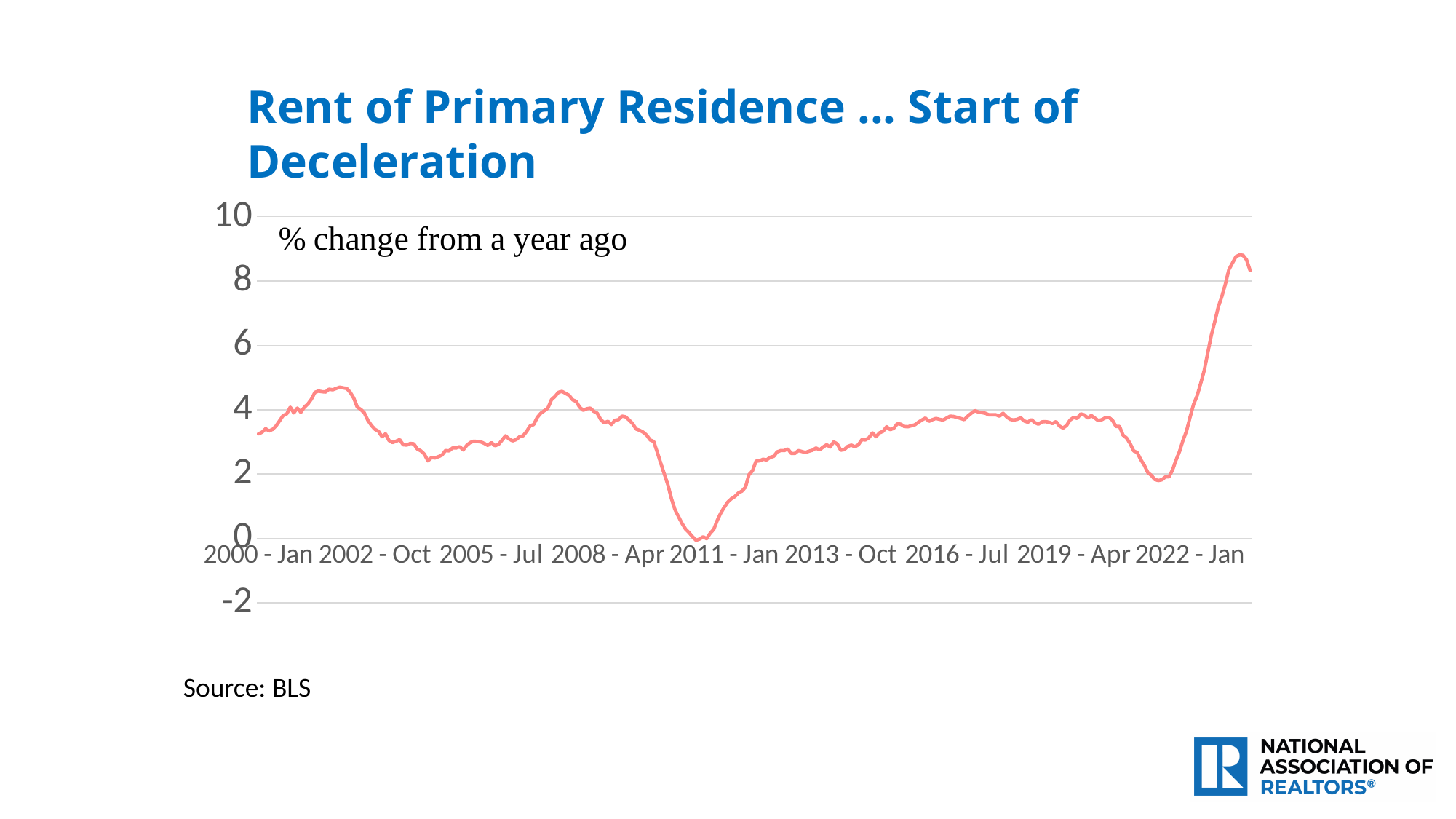
What kind of chart is shown on the slide? line chart Is the value at 2000 - Jan greater or less than 2? greater What does the text inside the plot area say the values represent? % change from a year ago Is the value at 2011 - Jan greater or less than 2? less How many date labels are shown on the x axis? 9 Is the value at 2019 - Apr greater or less than 6? less What is the title of the chart? Rent of Primary Residence … Start of Deceleration Does the line rise or fall between 2011 - Jan and 2013 - Oct? rise Which x-axis label is closest to the lowest point of the line? 2011 - Jan Does the line rise or fall between 2008 - Apr and 2011 - Jan? fall